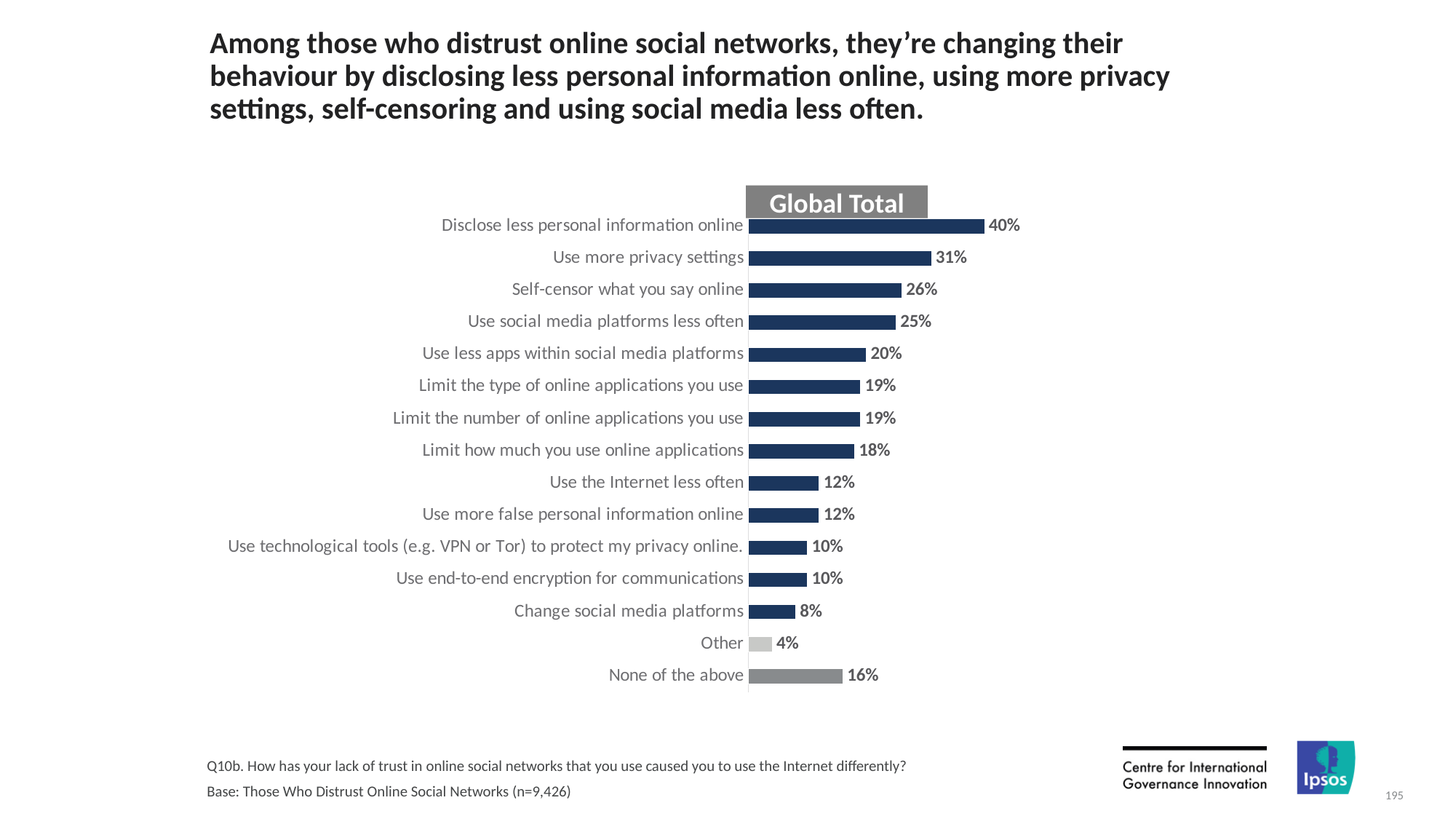
Which category has the highest value? Disclose less personal information online What is the value for "Disclose less personal information online"? 40% What is the difference between "Disclose less personal information online" and "Use more privacy settings"? 9% What is the value for "Change social media platforms"? 8% Which category has the lowest value? Other What is the difference between "Self-censor what you say online" and "Use the Internet less often"? 14% What is the value for "None of the above"? 16% Which is larger: "Use social media platforms less often" or "Use less apps within social media platforms"? Use social media platforms less often How many categories are shown in the chart? 15 What kind of chart is shown on the slide? Bar chart What is the value for "Use more privacy settings"? 31% What is the label shown in the grey box above the chart? Global Total